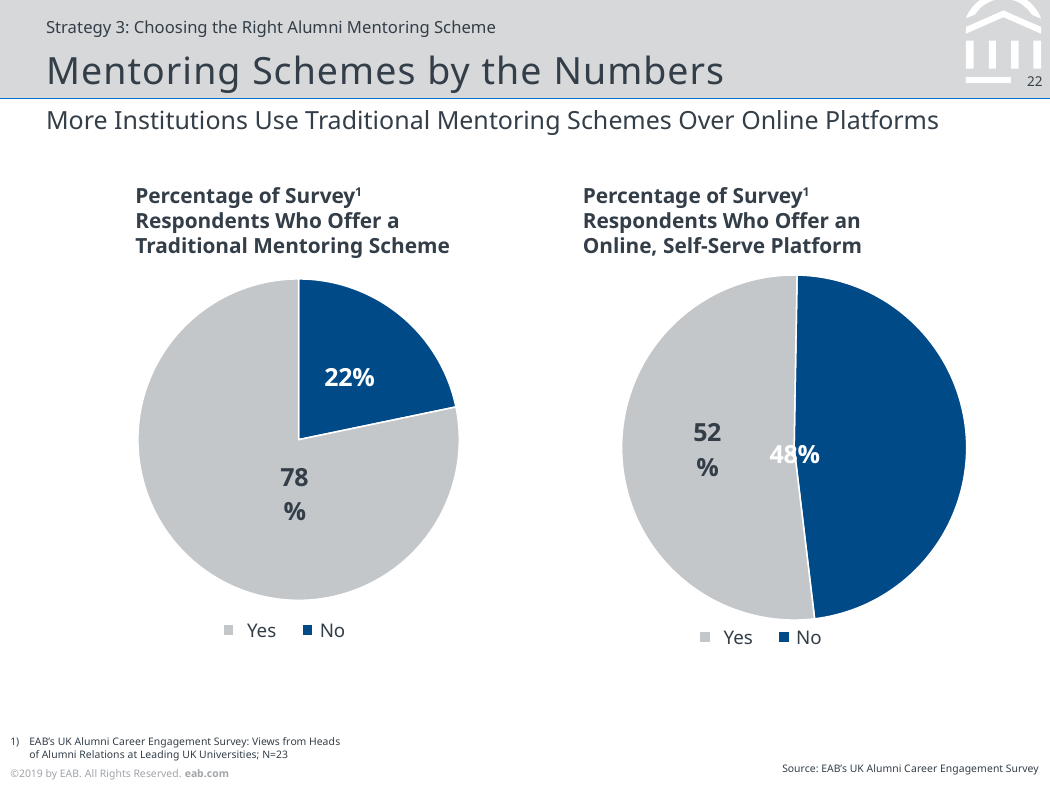
In the left chart (Traditional Mentoring Scheme), what percentage of respondents answered No? 22% In the right chart (Online, Self-Serve Platform), what percentage of respondents answered No? 48% What type of chart is used on this slide? Pie chart In the right chart (Online, Self-Serve Platform), what is the difference between the Yes and No percentages? 4% In the left chart (Traditional Mentoring Scheme), which response has the larger share? Yes Is the Yes share in the left chart (Traditional Mentoring Scheme) larger or smaller than the Yes share in the right chart (Online, Self-Serve Platform)? Larger In the right chart (Online, Self-Serve Platform), which response has the smaller share? No In the left chart (Traditional Mentoring Scheme), what is the difference between the Yes and No percentages? 56% In the left chart (Traditional Mentoring Scheme), which colour represents the No response? Blue In the left chart (Traditional Mentoring Scheme), what percentage of respondents answered Yes? 78% How many slices does each pie chart on the slide have? 2 In the right chart (Online, Self-Serve Platform), what percentage of respondents answered Yes? 52%